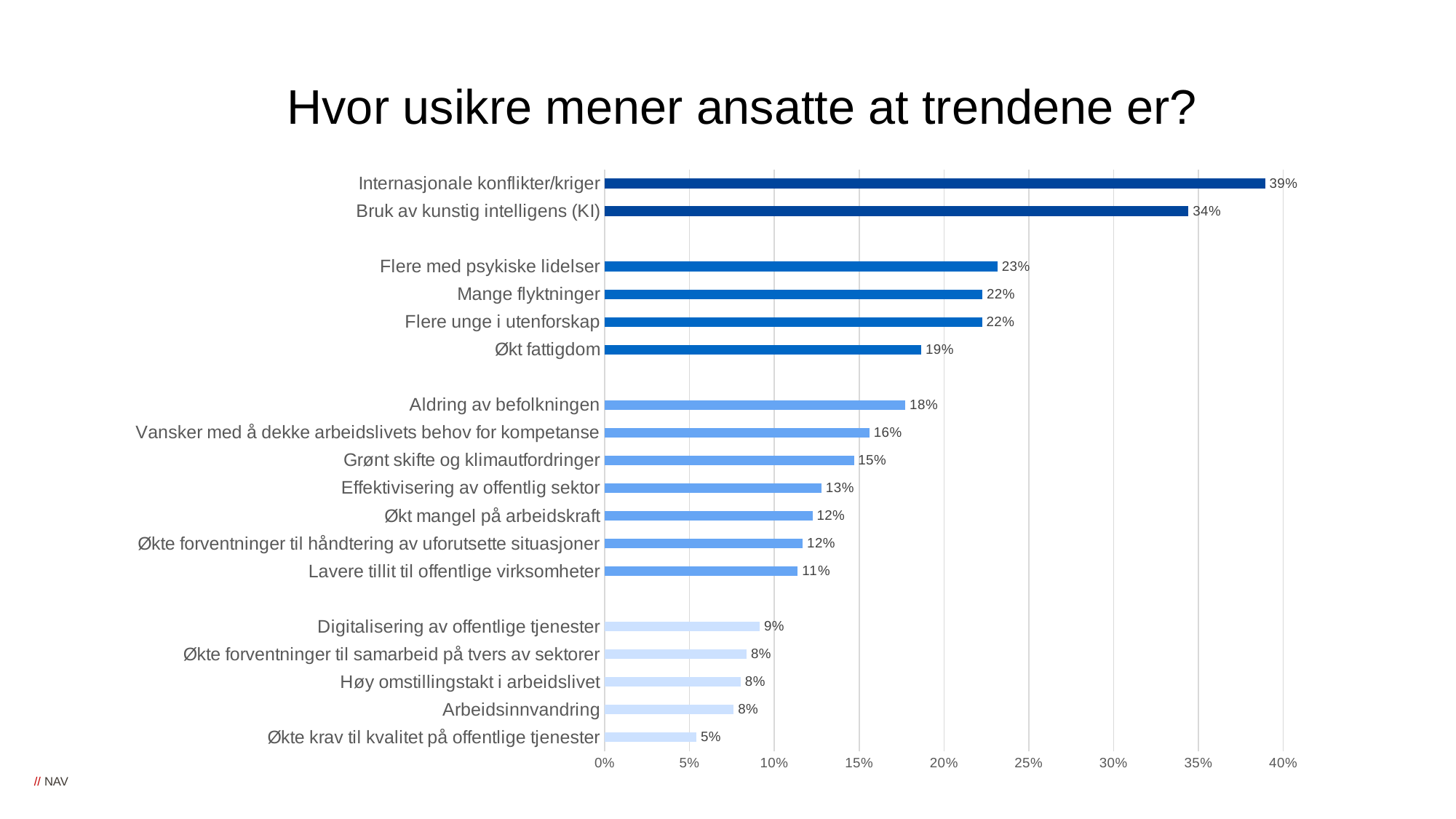
How many categories are shown in the chart? 18 What is the value for Bruk av kunstig intelligens (KI)? 34% What is the difference between the values for Internasjonale konflikter/kriger and Bruk av kunstig intelligens (KI)? 5% Which category has the highest value? Internasjonale konflikter/kriger What kind of chart is shown on the slide? Bar chart What is the value for Aldring av befolkningen? 18% What is the difference between the values for Flere med psykiske lidelser and Økt fattigdom? 4% What is the title of the slide? Hvor usikre mener ansatte at trendene er? Which category has the lowest value? Økte krav til kvalitet på offentlige tjenester What is the value for Internasjonale konflikter/kriger? 39% Which is larger, the value for Grønt skifte og klimautfordringer or the value for Digitalisering av offentlige tjenester? Grønt skifte og klimautfordringer What is the value for Lavere tillit til offentlige virksomheter? 11%